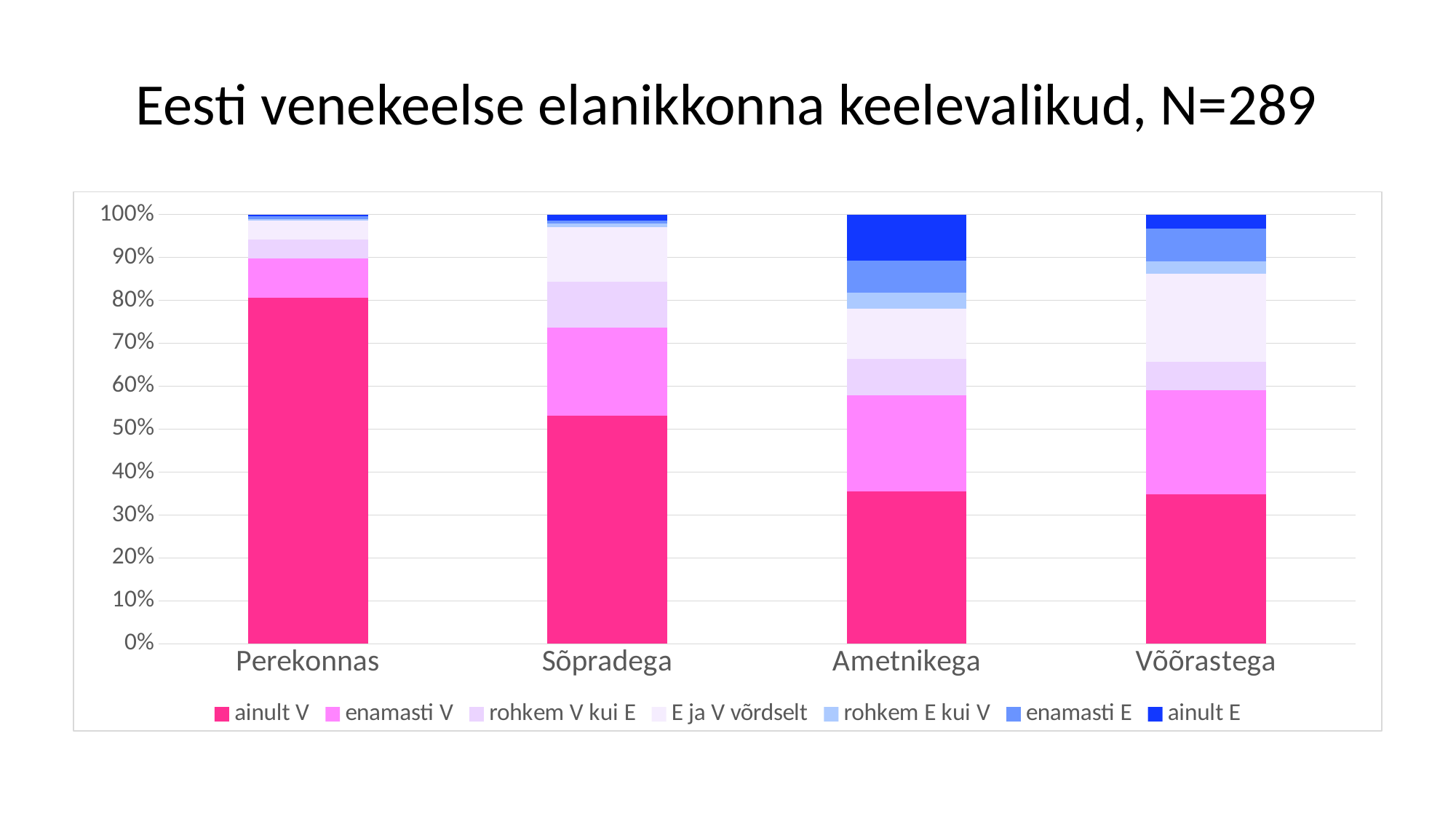
How many categories are shown on the x axis? 4 Which category has the largest 'ainult V' share? Perekonnas Which has a larger 'enamasti V' share, Perekonnas or Sõpradega? Sõpradega Is the 'ainult V' share for Sõpradega greater or less than 50%? greater What is the title of the chart? Eesti venekeelse elanikkonna keelevalikud, N=289 How many series does the legend list? 7 What kind of chart is shown on the slide? stacked bar chart Which series is listed first in the legend? ainult V Is the 'ainult V' share for Perekonnas greater or less than 70%? greater Which has a larger 'ainult E' share, Perekonnas or Ametnikega? Ametnikega Which category has the largest 'ainult E' share? Ametnikega Is the 'ainult V' share for Ametnikega greater or less than 40%? less